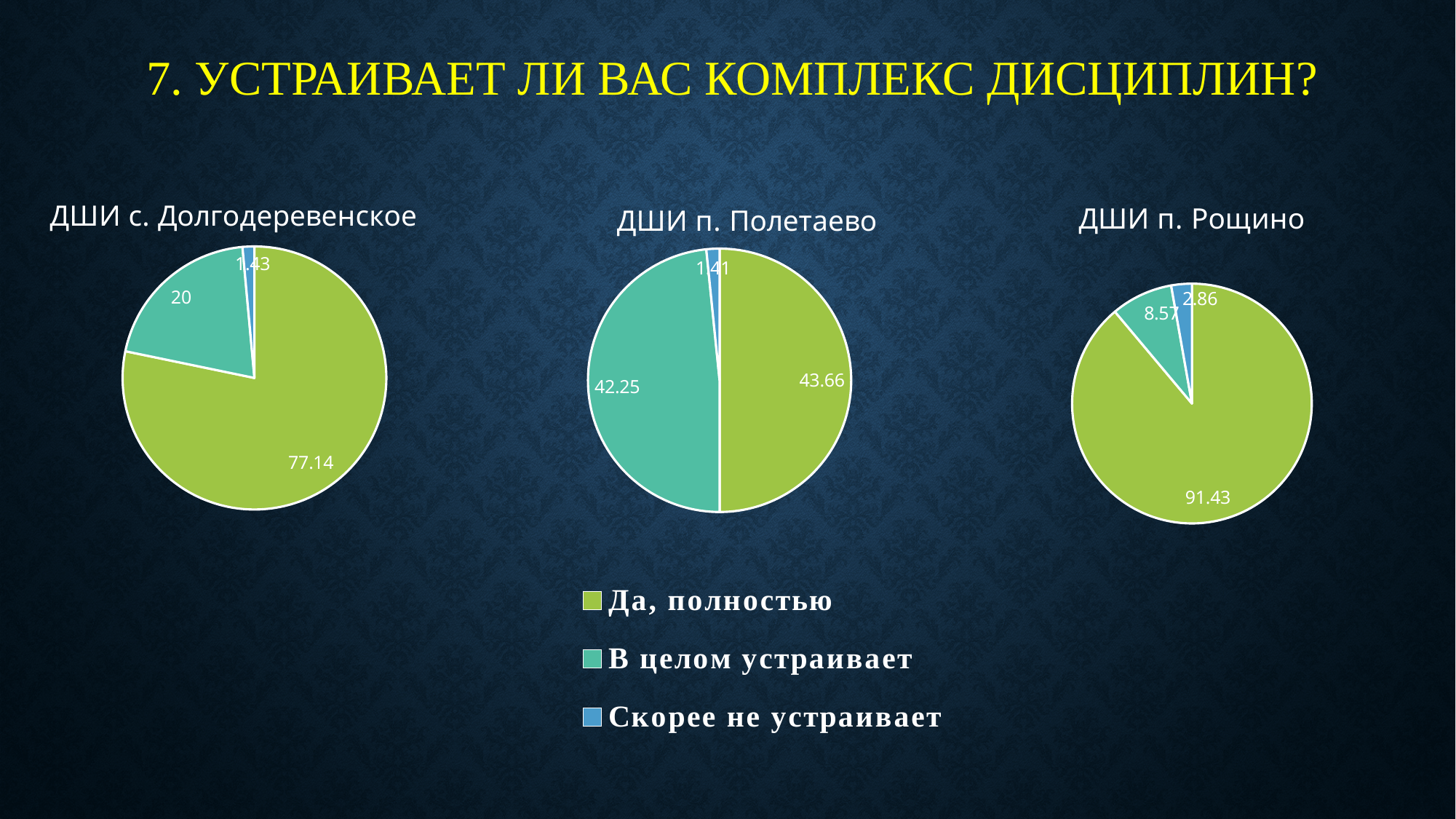
How many pie charts are shown on the slide? 3 In the 'ДШИ п. Полетаево' pie chart, which is larger: 'Да, полностью' or 'В целом устраивает'? Да, полностью What type of chart is used for 'ДШИ п. Рощино'? Pie chart In the 'ДШИ с. Долгодеревенское' pie chart, which category has the smallest slice? Скорее не устраивает In the 'ДШИ с. Долгодеревенское' pie chart, what is the value for 'Да, полностью'? 77.14 In the 'ДШИ п. Полетаево' pie chart, what is the value for 'В целом устраивает'? 42.25 How many slices does the 'ДШИ п. Полетаево' pie chart have? 3 In the 'ДШИ п. Рощино' pie chart, which category has the largest slice? Да, полностью In the 'ДШИ с. Долгодеревенское' pie chart, what is the difference between the values for 'Да, полностью' and 'В целом устраивает'? 57.14 In the 'ДШИ п. Рощино' pie chart, what is the difference between the values for 'Да, полностью' and 'В целом устраивает'? 82.86 How many entries does the shared legend list? 3 In the 'ДШИ п. Рощино' pie chart, what is the value for 'Скорее не устраивает'? 2.86